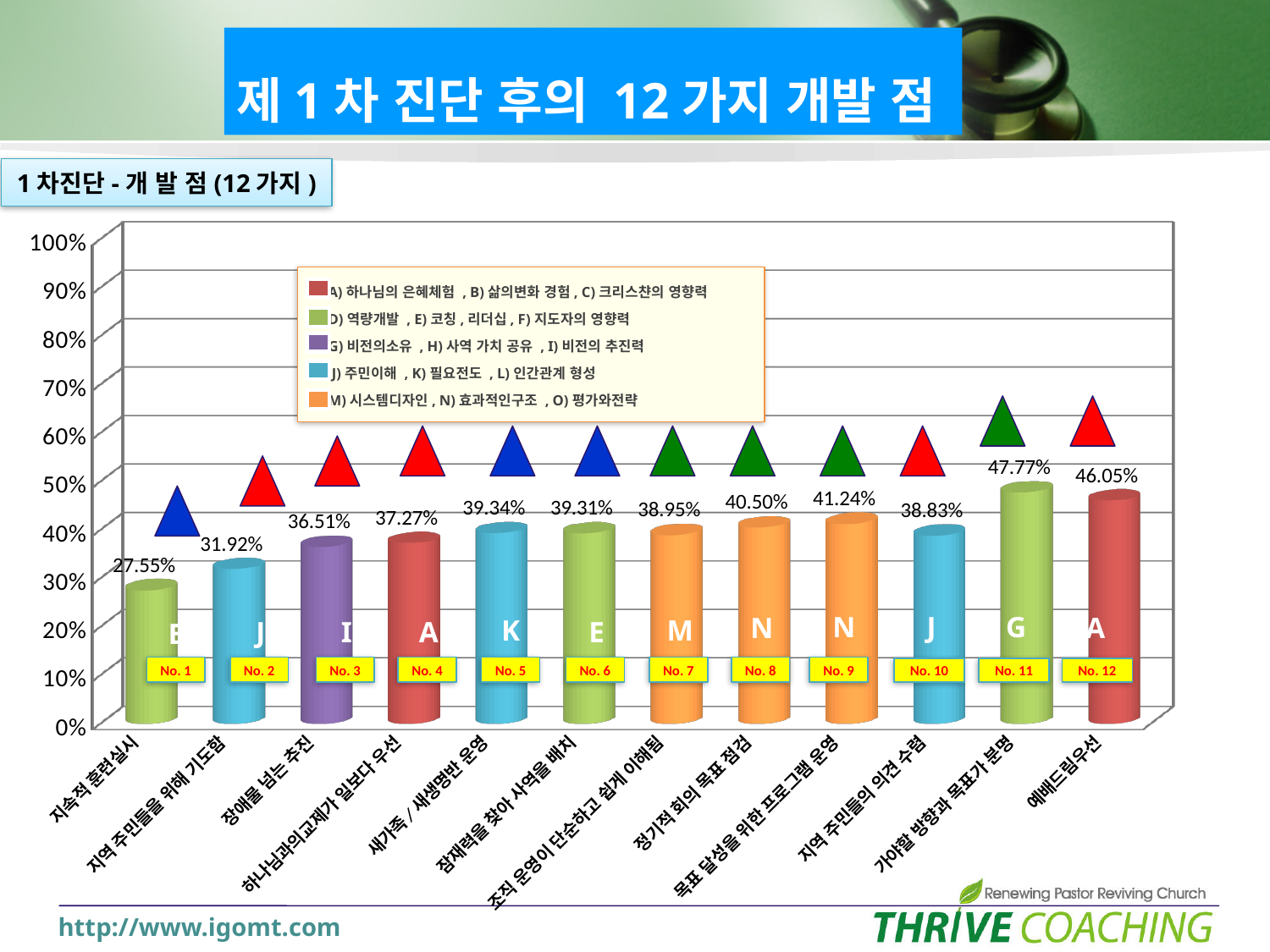
What is the value for 가야할 방향과 목표가 분명 (No. 11)? 47.77% What is the value for 정기적 회의 목표 점검 (No. 8)? 40.50% How many bars (categories) are plotted in the chart? 12 Which is larger: the value for 목표 달성을 위한 프로그램 운영 (No. 9) or the value for 지역 주민들의 의견 수렴 (No. 10)? 목표 달성을 위한 프로그램 운영 What is the value for 예배드림우선 (No. 12)? 46.05% What is the difference between the values for 예배드림우선 (46.05%) and 지속적 훈련실시 (27.55%)? 18.50% How many entries does the legend list? 5 What type of chart is shown on the slide? bar chart Which category has the lowest value? 지속적 훈련실시 What is the value for 지속적 훈련실시 (No. 1)? 27.55% Which category has the highest value? 가야할 방향과 목표가 분명 Is the value for 지역 주민들을 위해 기도함 (No. 2) greater or less than 40%? less